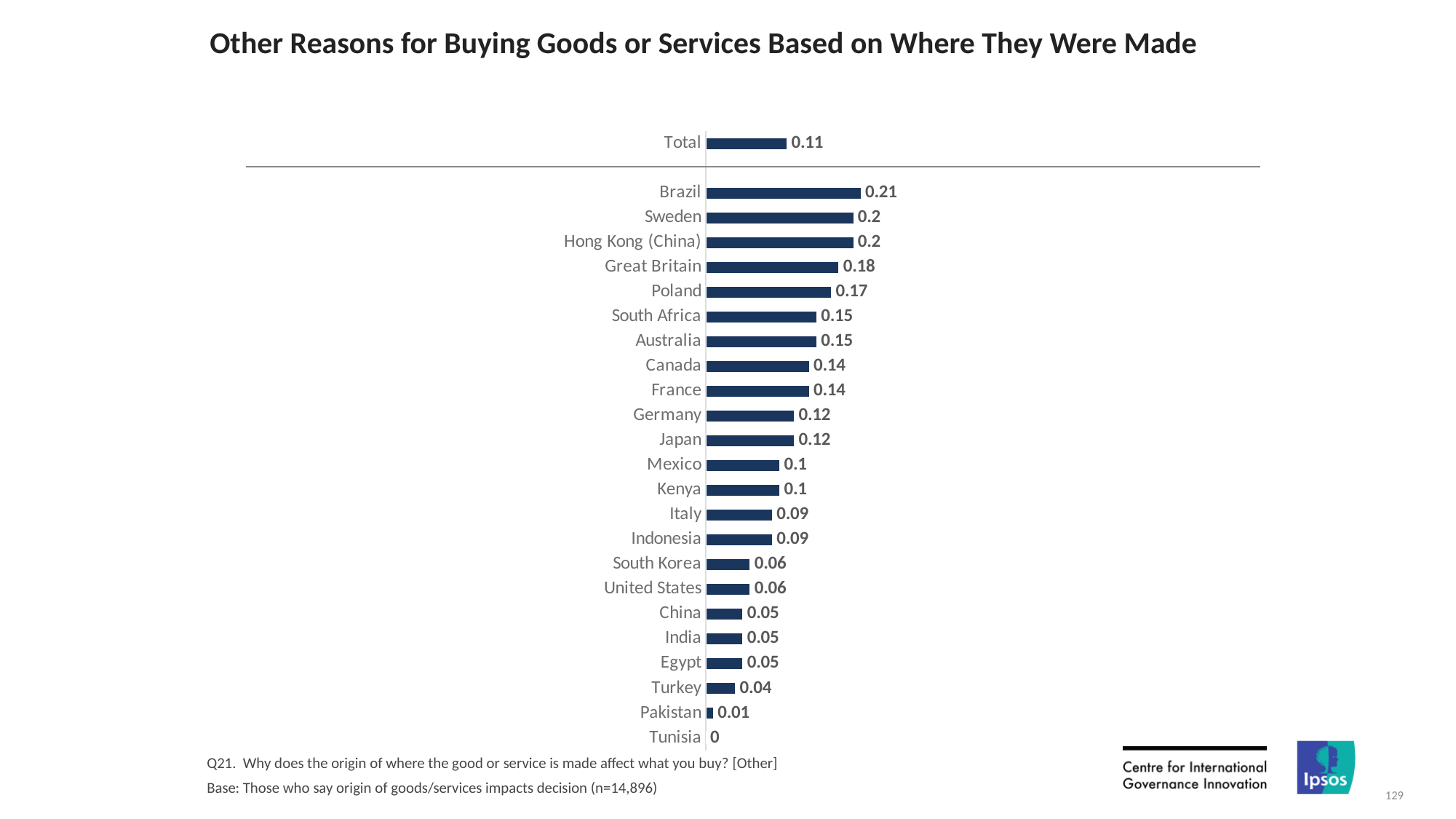
Which is larger, the value for Canada or the value for Germany? Canada How many countries are shown below the Total bar? 23 What is the value for Brazil? 0.21 What is the value for Great Britain? 0.18 What is the difference between the values for Total and Turkey? 0.07 What is the title of the chart? Other Reasons for Buying Goods or Services Based on Where They Were Made What is the difference between the values for Brazil and Poland? 0.04 Which country has the highest value? Brazil What is the value for Total? 0.11 Which country has the lowest value? Tunisia What is the value for Pakistan? 0.01 What kind of chart is shown on the slide? Bar chart